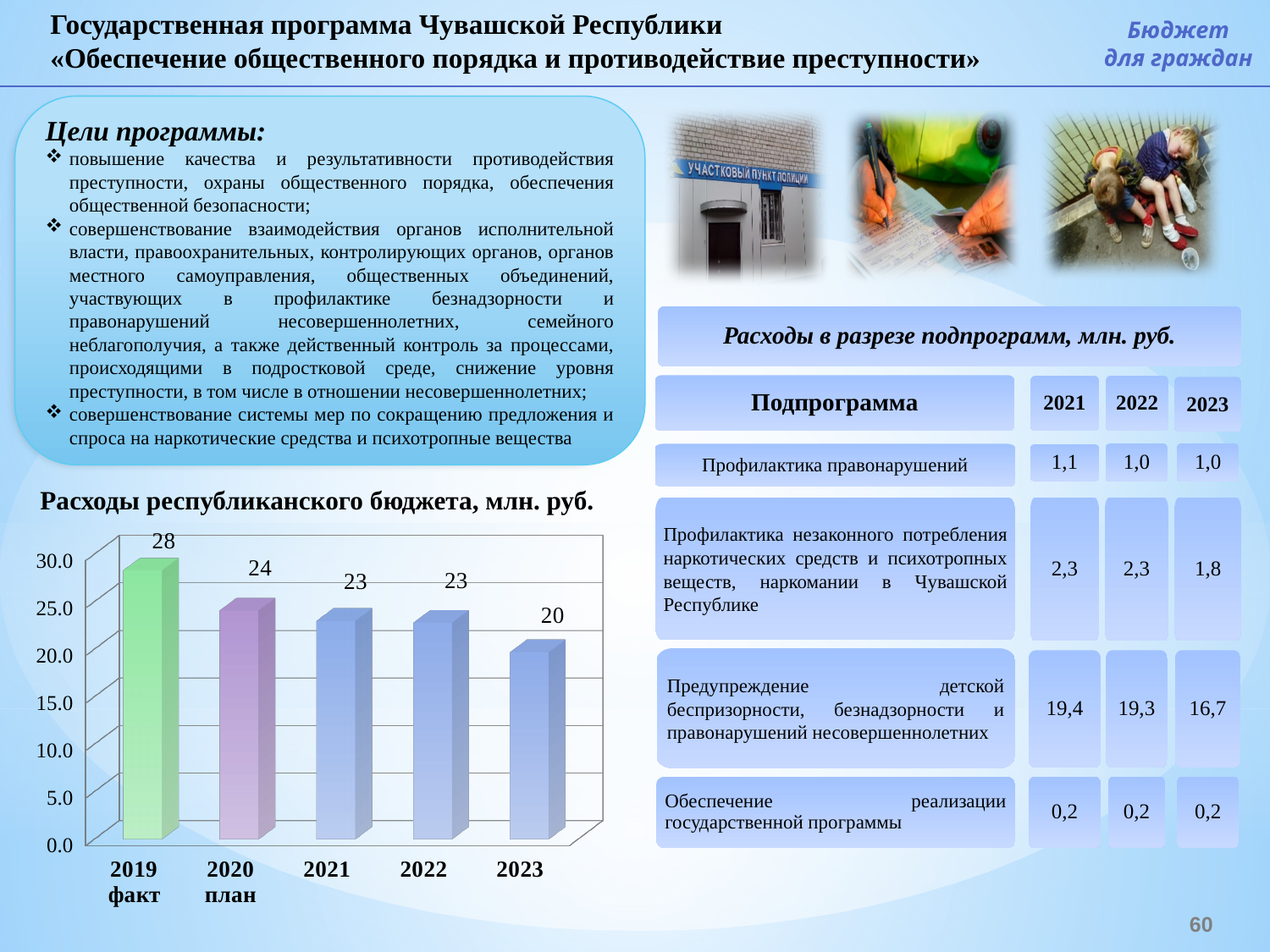
What is the difference between the values for 2020 план and 2021 in the chart 'Расходы республиканского бюджета, млн. руб.'? 1 Is the value for 2022 greater or less than 25.0 in the chart 'Расходы республиканского бюджета, млн. руб.'? less What is the value for 2023 in the chart 'Расходы республиканского бюджета, млн. руб.'? 20 What kind of chart is 'Расходы республиканского бюджета, млн. руб.'? bar chart What is the difference between the values for 2019 факт and 2023 in the chart 'Расходы республиканского бюджета, млн. руб.'? 8 Which year has the highest value in the chart 'Расходы республиканского бюджета, млн. руб.'? 2019 факт How many bars are shown in the chart 'Расходы республиканского бюджета, млн. руб.'? 5 Which is larger in the chart 'Расходы республиканского бюджета, млн. руб.': the value for 2020 план or the value for 2023? 2020 план What is the value for 2020 план in the chart 'Расходы республиканского бюджета, млн. руб.'? 24 Which year has the lowest value in the chart 'Расходы республиканского бюджета, млн. руб.'? 2023 Do the values in the chart 'Расходы республиканского бюджета, млн. руб.' generally rise or fall from 2019 to 2023? fall What is the value for 2019 факт in the chart 'Расходы республиканского бюджета, млн. руб.'? 28